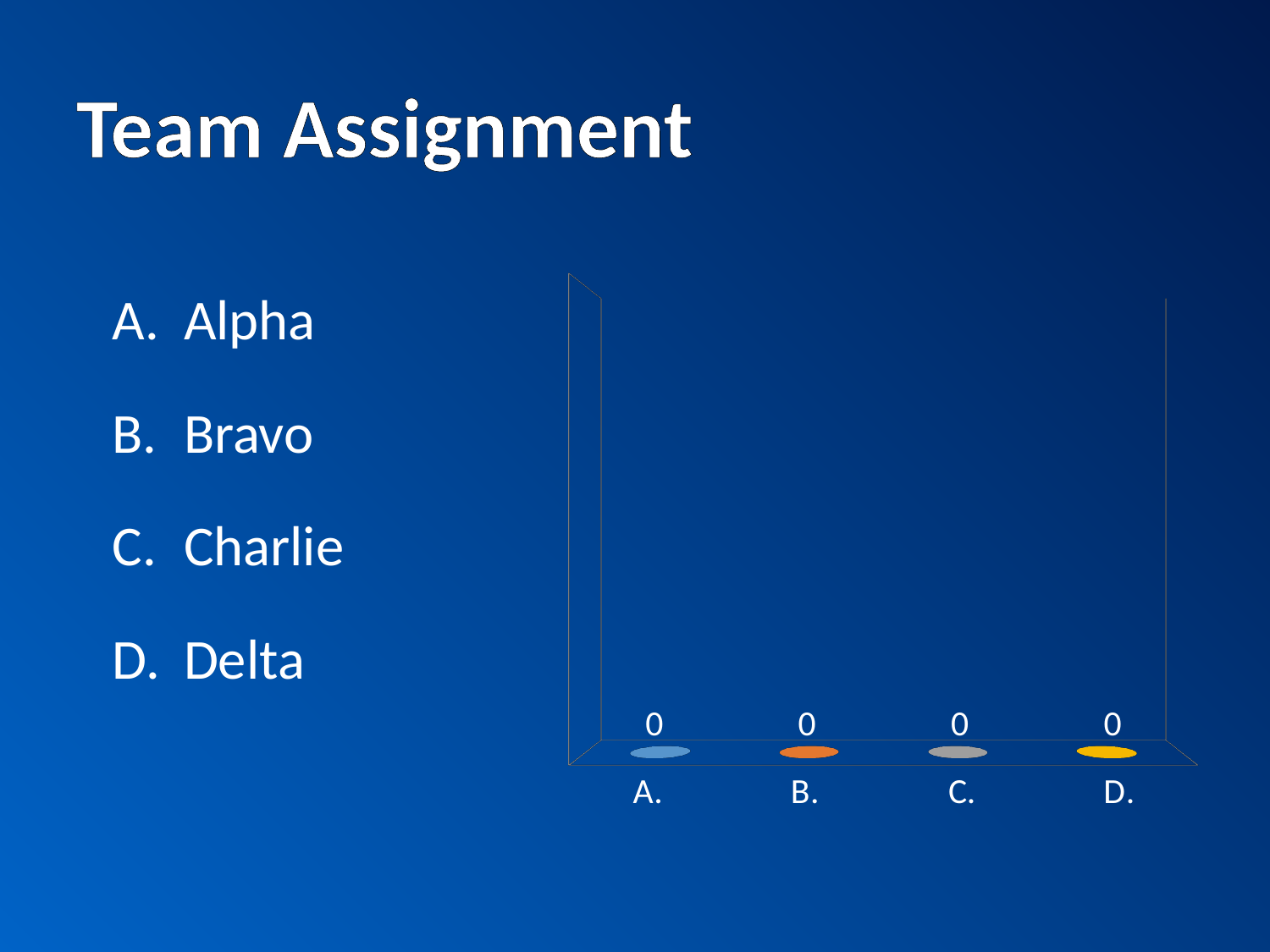
What is the value shown for category B. on the chart? 0 What is the difference between the values for A. and D. on the chart? 0 What colour is the bar for category B. on the chart? orange What is the value shown for category C. on the chart? 0 What is the value shown for category D. on the chart? 0 What is the value shown for category A. on the chart? 0 What kind of chart is shown on the slide? bar chart How many categories are shown on the chart's x axis? 4 Do the values rise, fall, or stay flat from A. to D. on the chart? stay flat What is the difference between the values for B. and C. on the chart? 0 What are the category labels along the chart's x axis, from left to right? A., B., C., D.